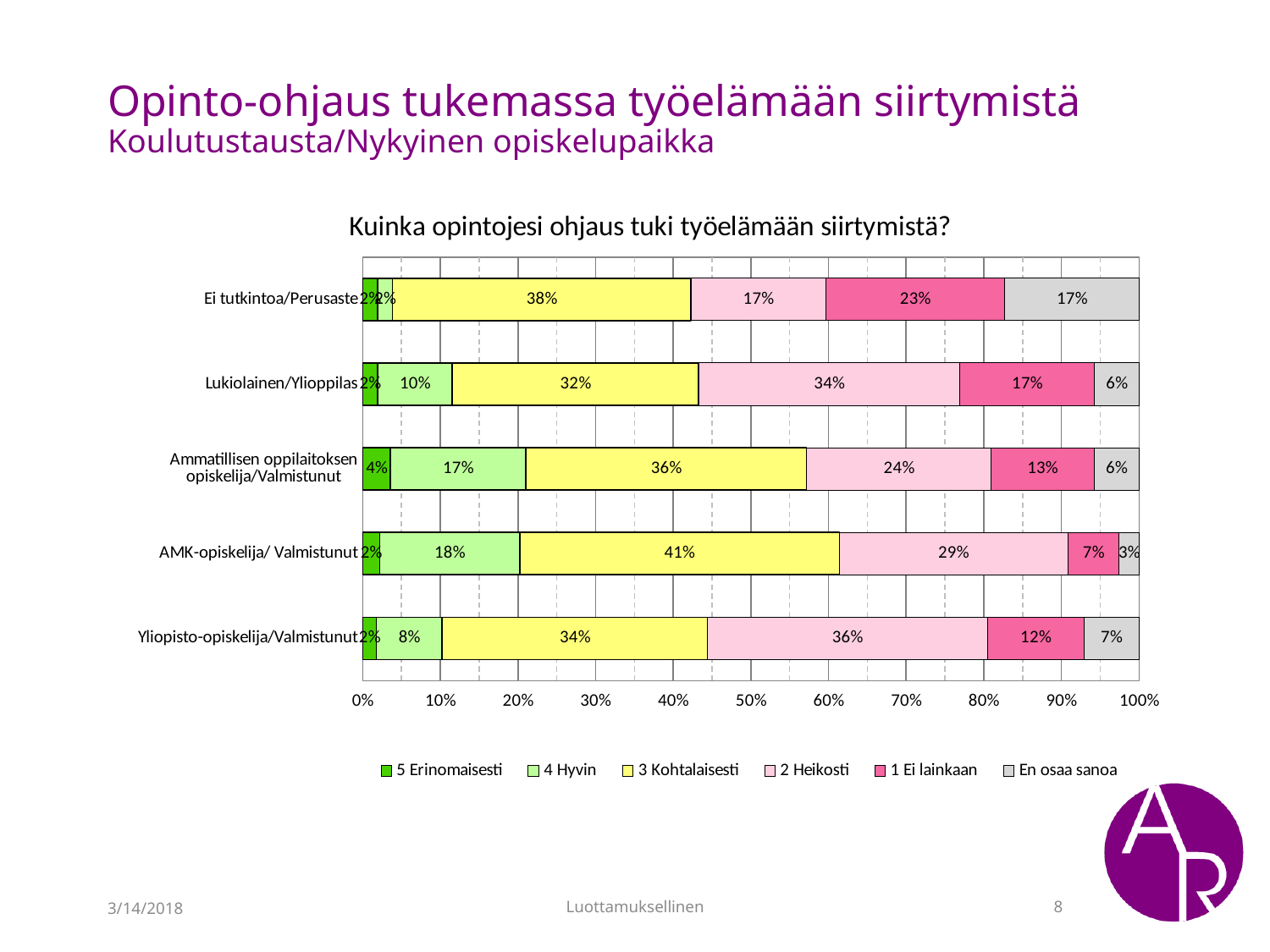
Which is larger: the 'En osaa sanoa' value for Ei tutkintoa/Perusaste or for Yliopisto-opiskelija/Valmistunut? Ei tutkintoa/Perusaste What is the value of '2 Heikosti' for Yliopisto-opiskelija/Valmistunut? 36% What is the value of '3 Kohtalaisesti' for AMK-opiskelija/ Valmistunut? 41% What is the value of '1 Ei lainkaan' for Ei tutkintoa/Perusaste? 23% What type of chart is shown on the slide? Stacked bar chart Which category has the highest value for '3 Kohtalaisesti'? AMK-opiskelija/ Valmistunut What is the value of '4 Hyvin' for Ammatillisen oppilaitoksen opiskelija/Valmistunut? 17% How many series does the legend list? 6 Which category has the lowest value for '1 Ei lainkaan'? AMK-opiskelija/ Valmistunut What is the difference between the '2 Heikosti' values for Lukiolainen/Ylioppilas and Ei tutkintoa/Perusaste? 17% How many categories (education backgrounds) are shown on the y axis of the chart? 5 What is the title of the chart? Kuinka opintojesi ohjaus tuki työelämään siirtymistä?